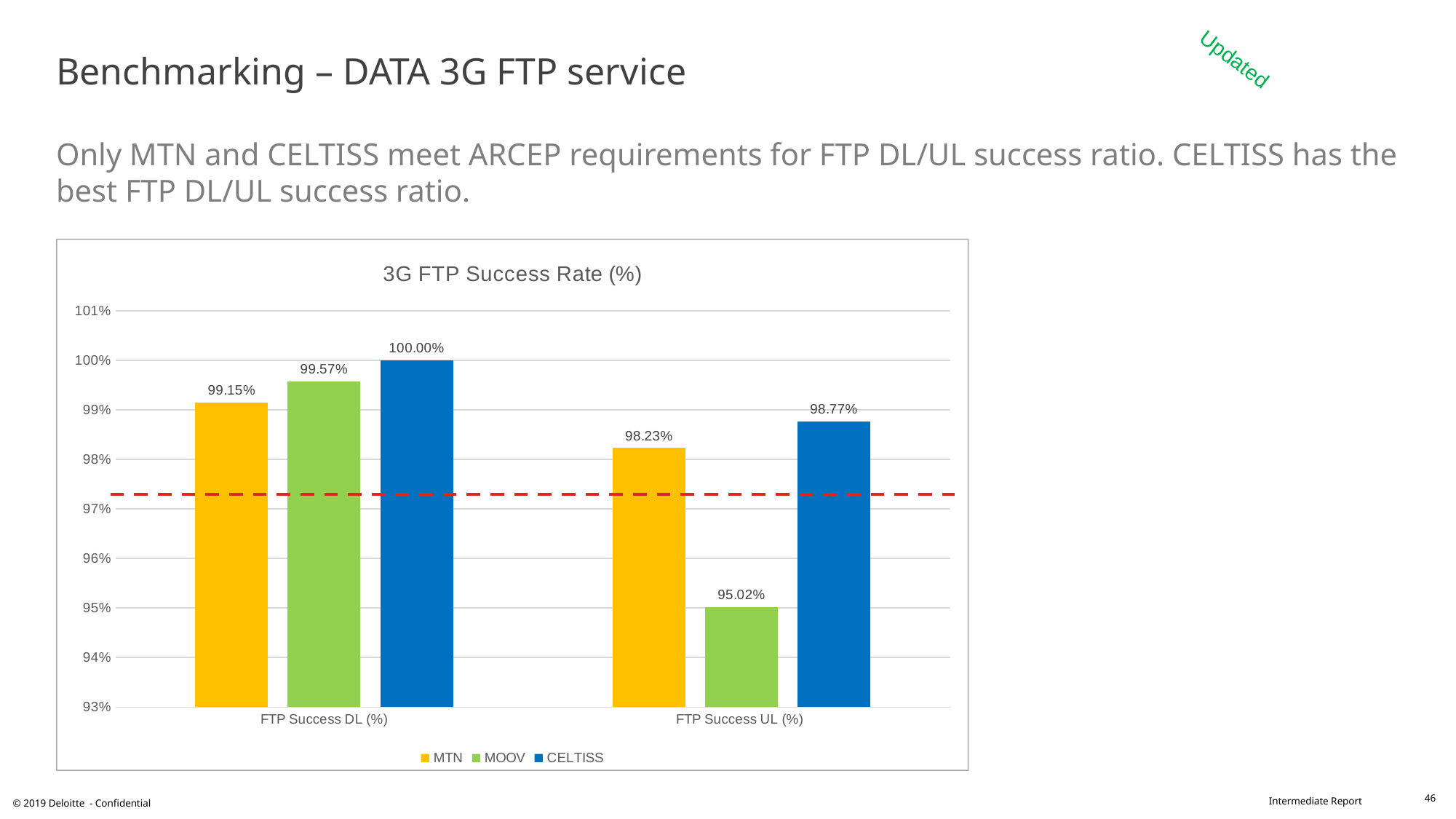
What is the MTN value for FTP Success DL (%)? 99.15% What is the CELTISS value for FTP Success UL (%)? 98.77% Which operator has the highest value for FTP Success DL (%)? CELTISS Which operator has the lowest value for FTP Success UL (%)? MOOV Is the MTN value for FTP Success UL (%) greater or less than 97%? greater What is the difference between the CELTISS and MTN values for FTP Success UL (%)? 0.54% How many series does the legend list? 3 Which is larger: the MOOV value for FTP Success DL (%) or the MOOV value for FTP Success UL (%)? FTP Success DL (%) What is the title of the chart? 3G FTP Success Rate (%) What is the MOOV value for FTP Success UL (%)? 95.02% What kind of chart is shown on the slide? Bar chart How many categories are shown on the x axis? 2